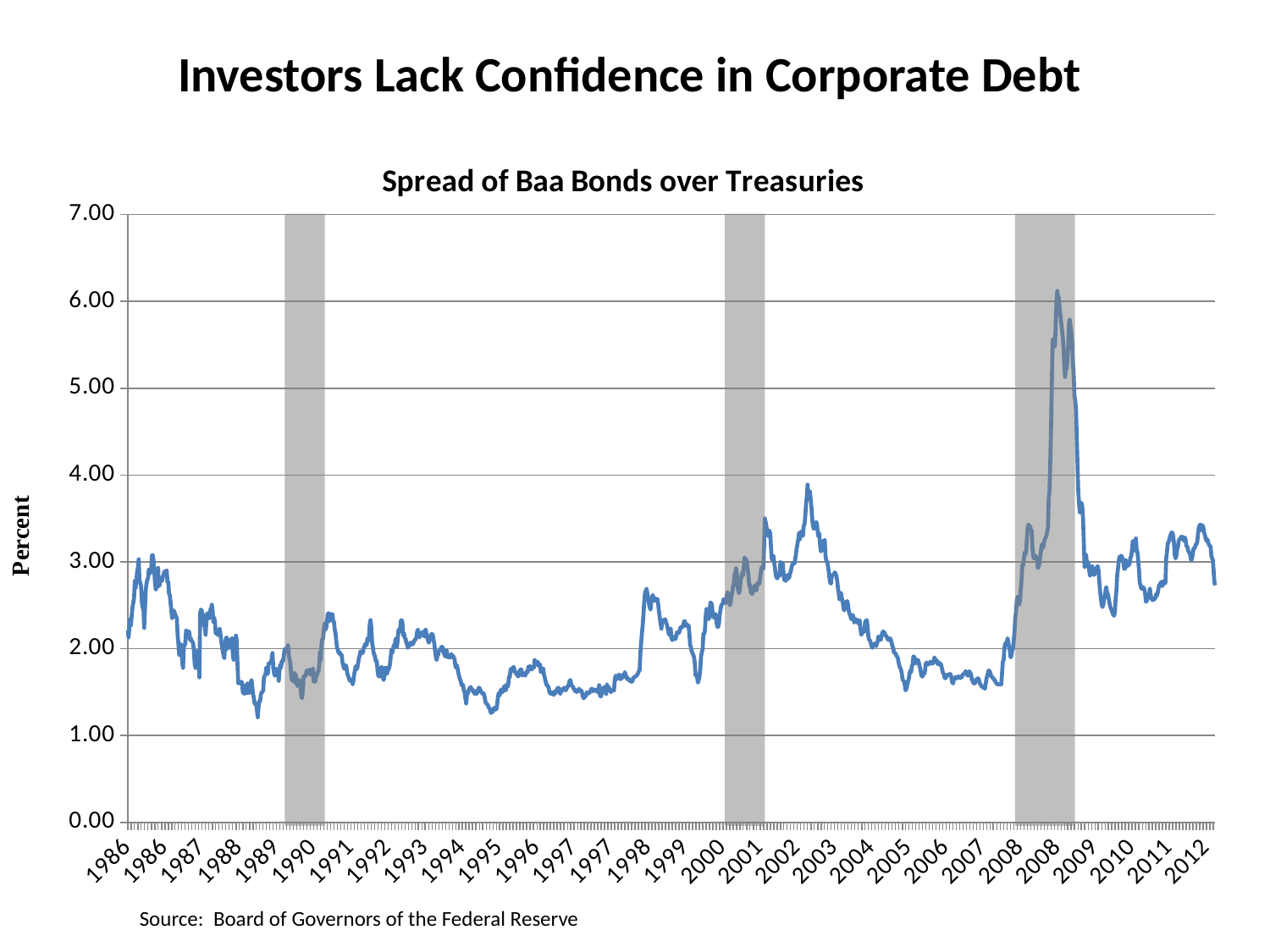
Which is larger, the peak of the spread in 2002 or the peak in 2008? 2008 Is the peak value of the spread in 2002 greater or less than 3.00? greater What kind of chart is shown on the slide? line chart Does the spread rise or fall from its 2008 peak to 2009? fall Is the final value of the spread in 2012 greater or less than 3.00? less Is the peak value of the spread in 2008 greater or less than 5.00? greater What is the label on the vertical axis of the chart? Percent In which year does the spread reach its highest value? 2008 Does the spread rise or fall from 2003 to 2005? fall Which is larger, the spread in 1995 or the spread in 2002? 2002 What is the title of the chart? Spread of Baa Bonds over Treasuries